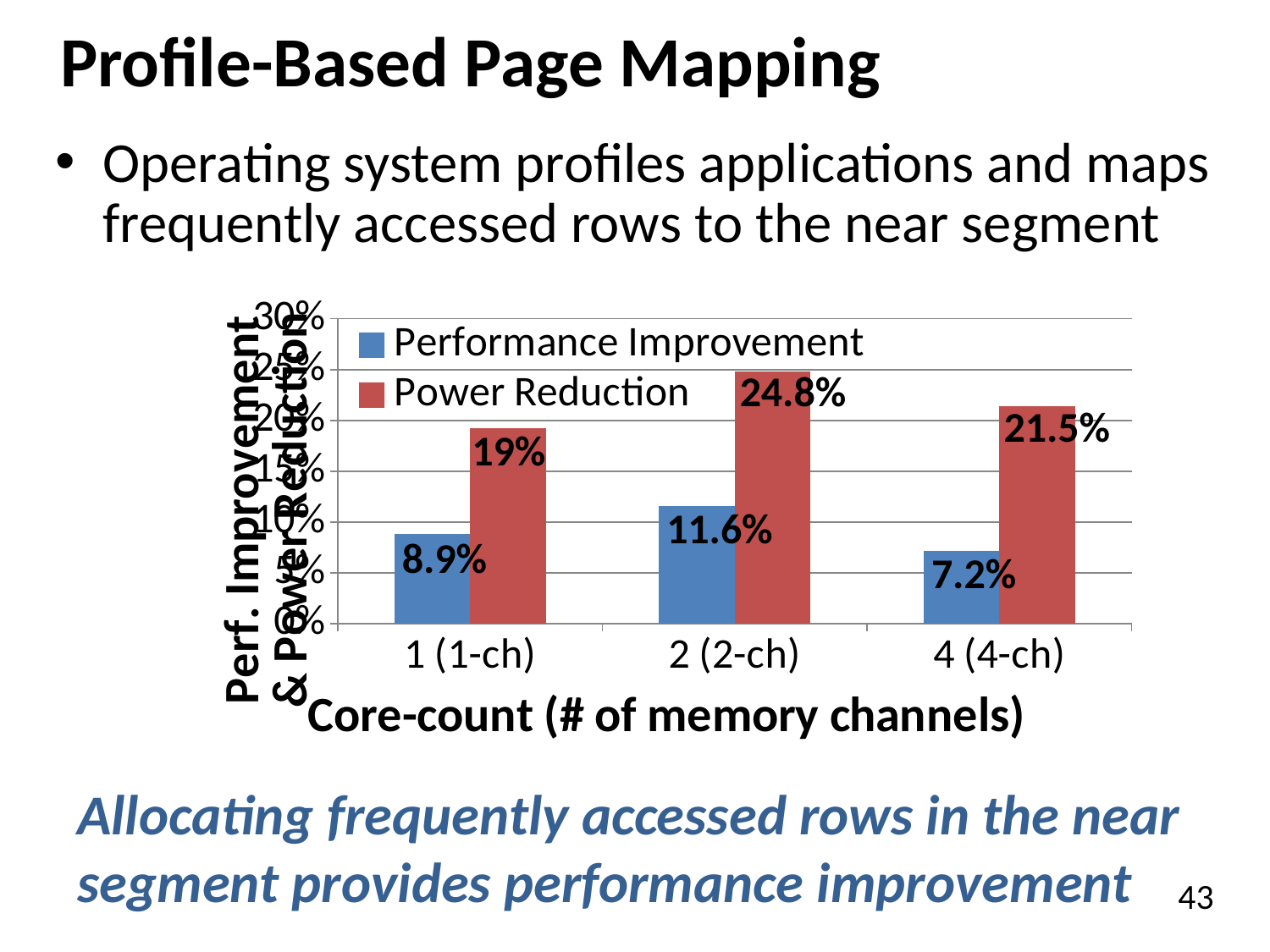
Which core-count has the lowest Performance Improvement? 4 (4-ch) How many core-count categories are shown on the x axis? 3 What kind of chart is shown on the slide? Bar chart What is the Power Reduction for 2 (2-ch)? 24.8% Which is larger, the Performance Improvement for 2 (2-ch) or for 1 (1-ch)? 2 (2-ch) Which core-count has the highest Power Reduction? 2 (2-ch) What is the difference between the Power Reduction and the Performance Improvement for 1 (1-ch)? 10.1% How many series does the legend list? 2 What is the title of the x axis of the chart? Core-count (# of memory channels) What is the Performance Improvement for 4 (4-ch)? 7.2% What is the Performance Improvement for 1 (1-ch)? 8.9% What is the Power Reduction for 4 (4-ch)? 21.5%